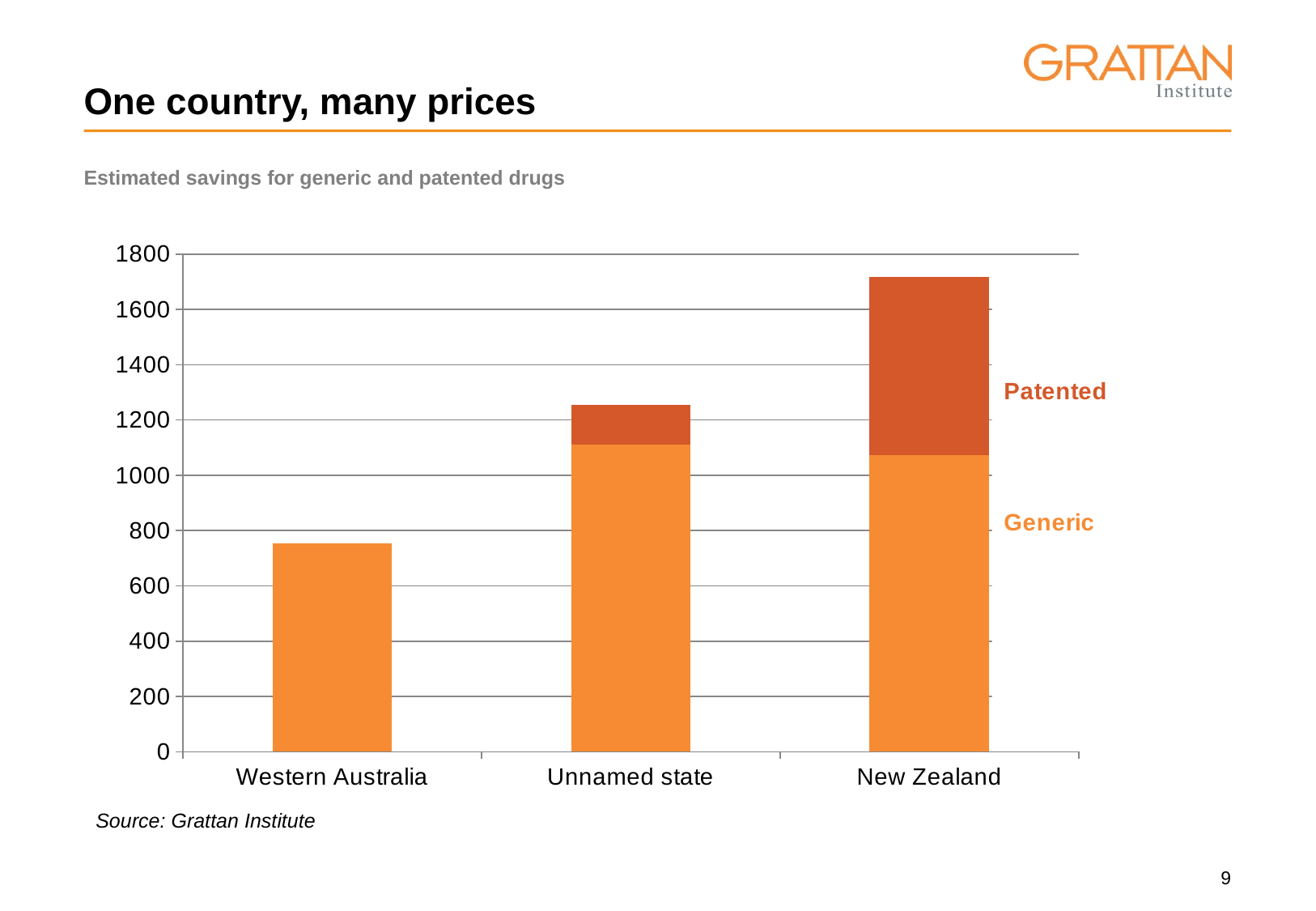
What kind of chart is shown on the slide? Bar chart Is the Generic value for New Zealand greater or less than 1000? greater Is the value for Western Australia greater or less than 800? less Which category has the highest total estimated savings? New Zealand Which has the larger Patented savings, Unnamed state or New Zealand? New Zealand Is the total for Unnamed state greater or less than 1200? greater Which category has the lowest total estimated savings? Western Australia Do the total savings rise or fall from Western Australia to New Zealand along the x axis? Rise How many categories are shown on the x axis? 3 How many series does the chart show? 2